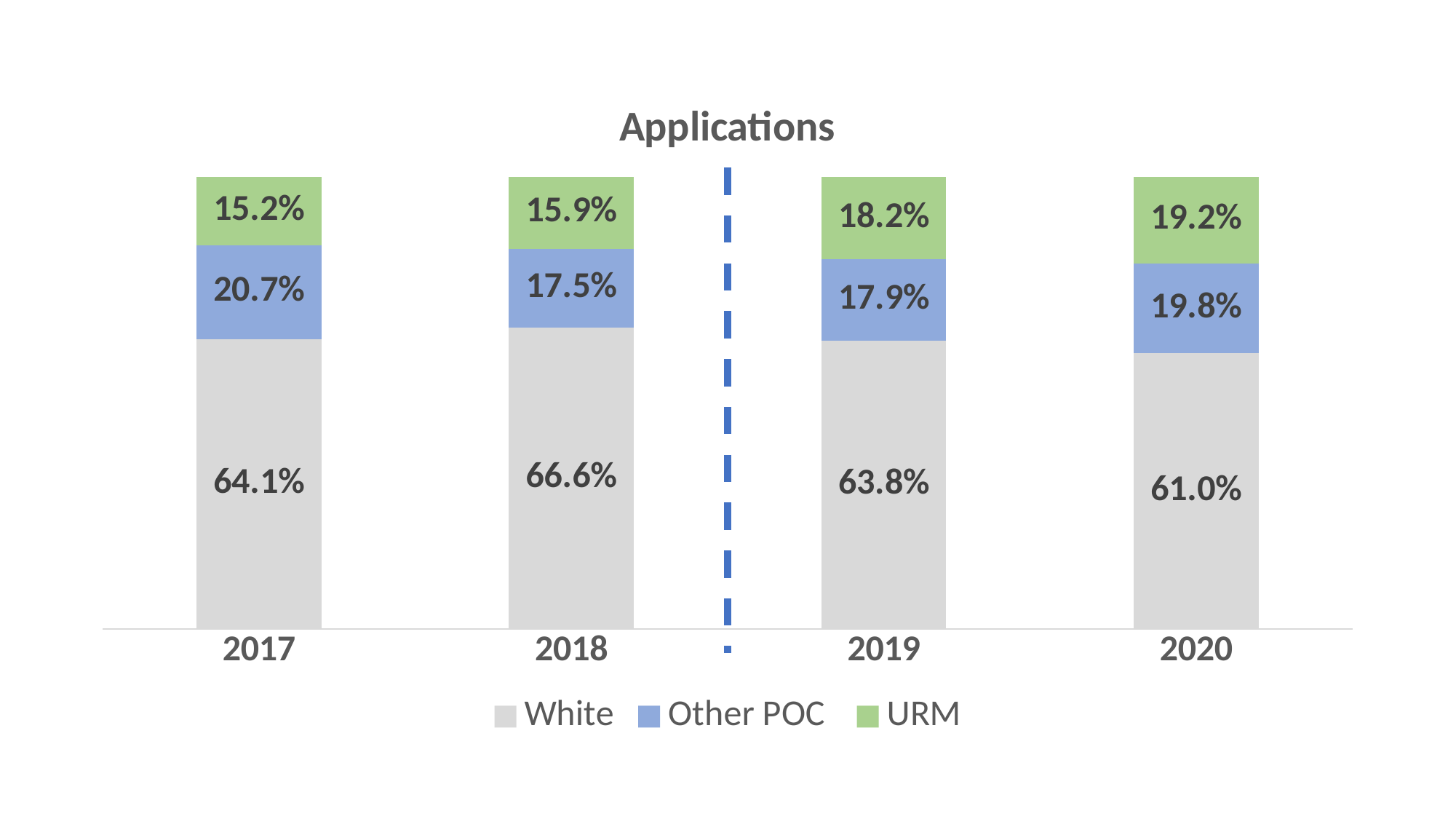
How many years are shown on the x axis? 4 How many series does the legend list? 3 What kind of chart is shown? Stacked bar chart In which year is the URM share of applications highest? 2020 What is the URM share of applications in 2020? 19.2% What is the White share of applications in 2018? 66.6% Which is larger in 2019: the Other POC share or the URM share? URM What is the Other POC share of applications in 2017? 20.7% Does the URM share rise or fall from 2017 to 2020? Rise In which year is the White share of applications lowest? 2020 What is the title of the chart? Applications What is the difference between the URM share in 2020 and in 2017? 4.0%